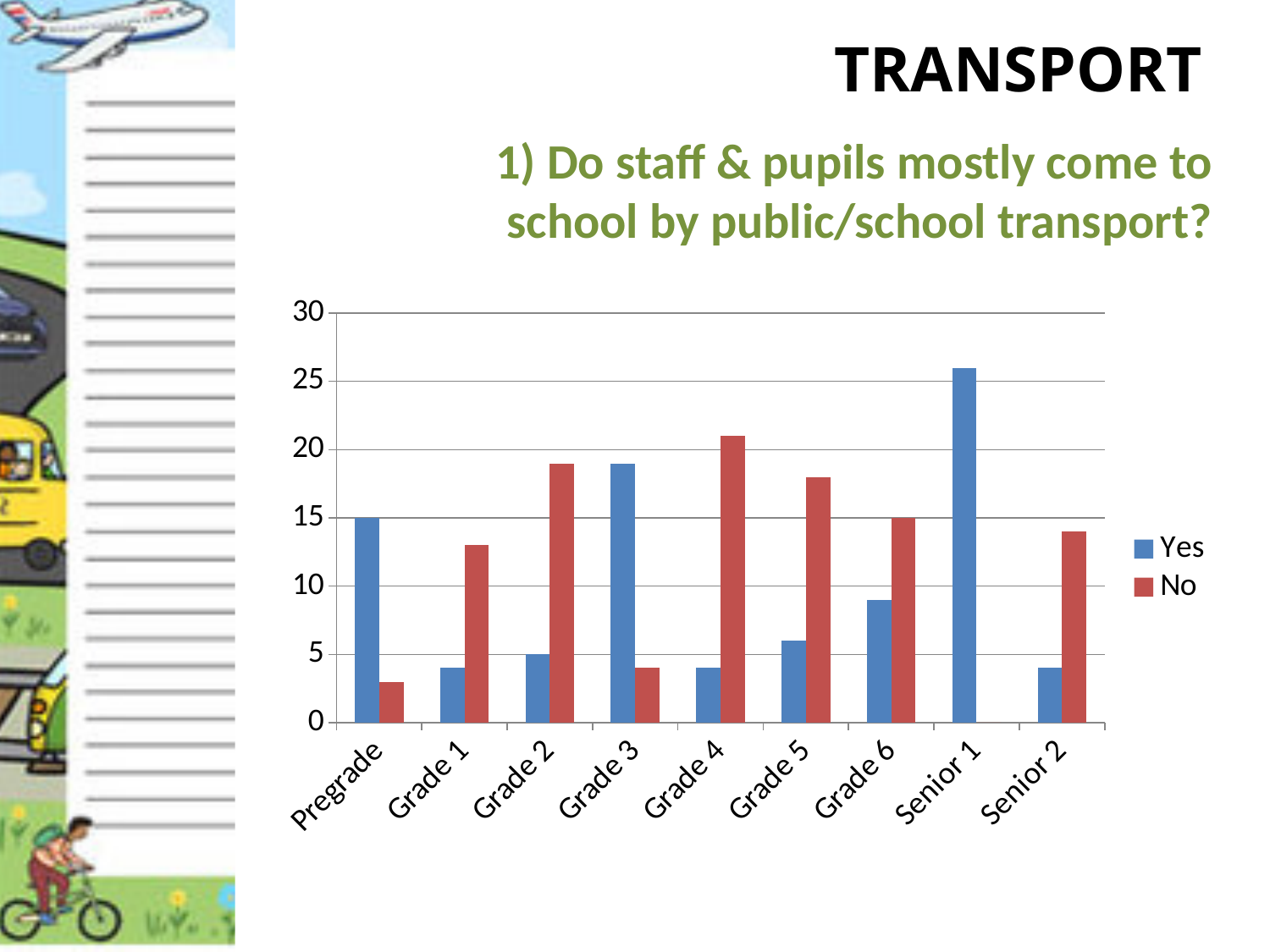
What type of chart is shown on the slide? bar chart For Grade 3, which is larger, the 'Yes' value or the 'No' value? Yes For Grade 2, which is larger, the 'Yes' value or the 'No' value? No Is the 'No' value for Grade 4 greater or less than 20? greater Is the 'Yes' value for Senior 1 greater or less than 25? greater Is the 'No' value for Grade 1 greater or less than 15? less How many grade categories are shown on the x axis? 9 Which category has the highest 'No' value? Grade 4 Which colour represents the 'No' series in the legend? red How many series does the legend list? 2 Which category has the highest 'Yes' value? Senior 1